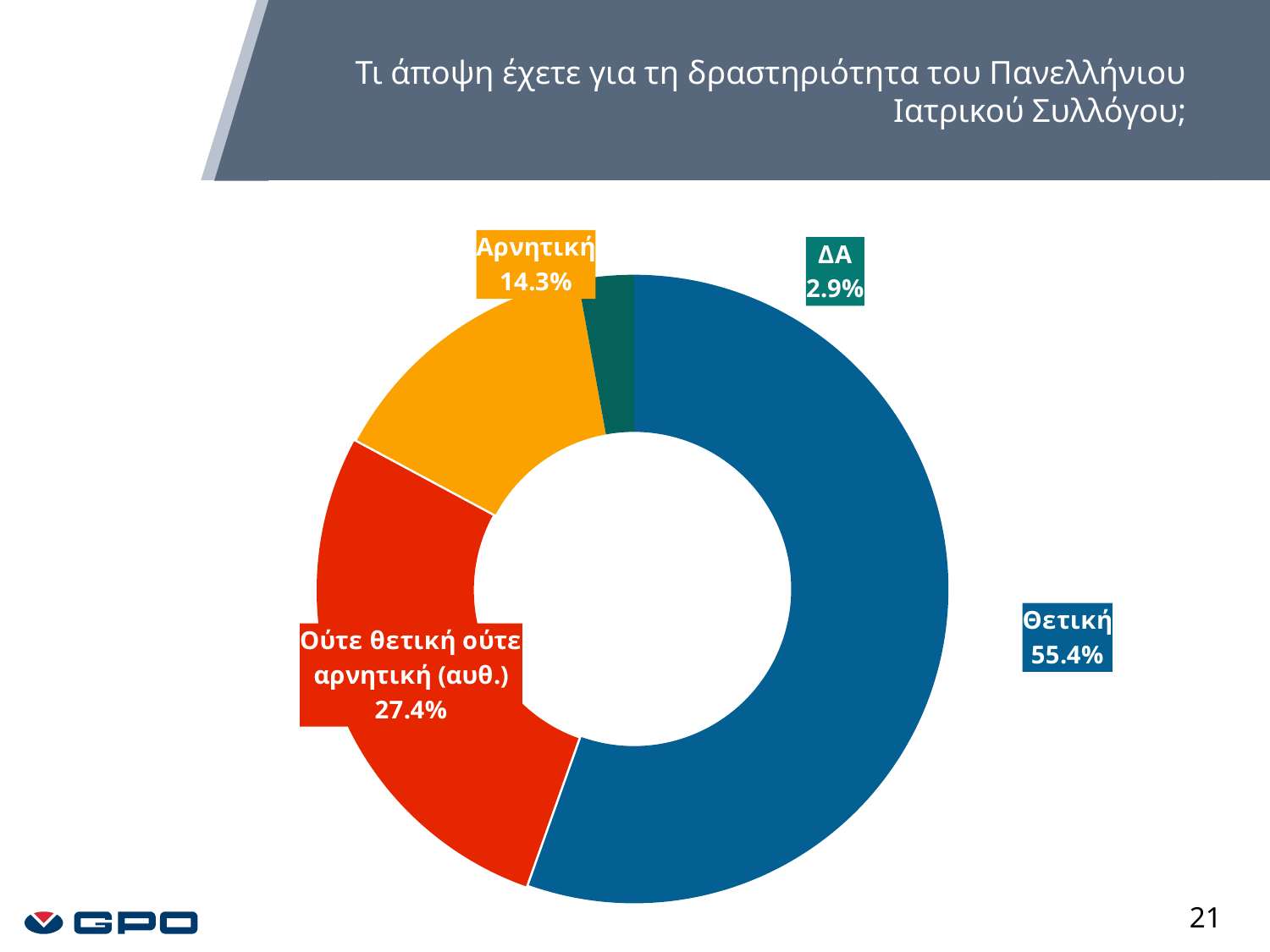
What is the difference in percentage points between Θετική and Ούτε θετική ούτε αρνητική (αυθ.)? 28.0 percentage points What kind of chart is shown on the slide? Pie chart (doughnut) What is the difference in percentage points between Αρνητική and ΔΑ? 11.4 percentage points What percentage of respondents answered ΔΑ? 2.9% Which is larger, the share for Αρνητική or the share for Ούτε θετική ούτε αρνητική (αυθ.)? Ούτε θετική ούτε αρνητική (αυθ.) How many categories are shown in the chart? 4 Which category has the largest share of the chart? Θετική What percentage of respondents answered Ούτε θετική ούτε αρνητική (αυθ.)? 27.4% What percentage of respondents answered Αρνητική? 14.3% What colour is the Θετική segment of the chart? Blue What percentage of respondents answered Θετική? 55.4% Which category has the smallest share of the chart? ΔΑ